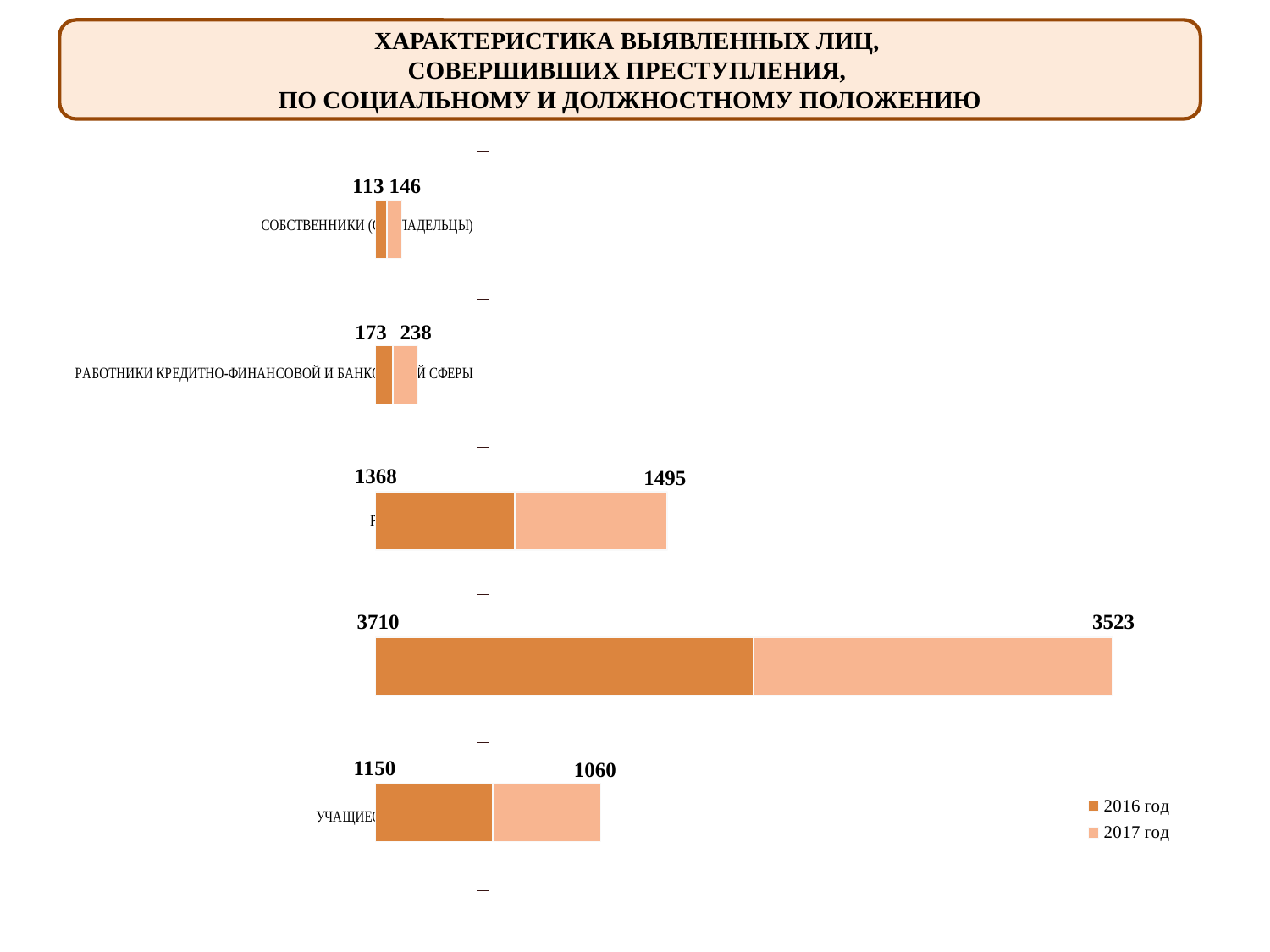
What is the 2016 год value for the bottom category (УЧАЩИЕСЯ)? 1150 How many categories are plotted in the chart? 5 What is the difference between the 2016 год and 2017 год values for the fourth category from the top? 187 Which series is shown in the lighter orange colour? 2017 год What is the 2017 год value for РАБОТНИКИ КРЕДИТНО-ФИНАНСОВОЙ И БАНКОВСКОЙ СФЕРЫ? 238 What is the 2017 год value for the top category (СОБСТВЕННИКИ)? 146 How many series does the legend list? 2 Which category has the highest 2016 год value? the fourth category from the top (3710) Which category has the lowest 2017 год value? СОБСТВЕННИКИ (146) What is the 2016 год value for РАБОТНИКИ КРЕДИТНО-ФИНАНСОВОЙ И БАНКОВСКОЙ СФЕРЫ? 173 What type of chart is shown on the slide? bar chart For the bottom category (УЧАЩИЕСЯ), which is larger: the 2016 год value or the 2017 год value? 2016 год